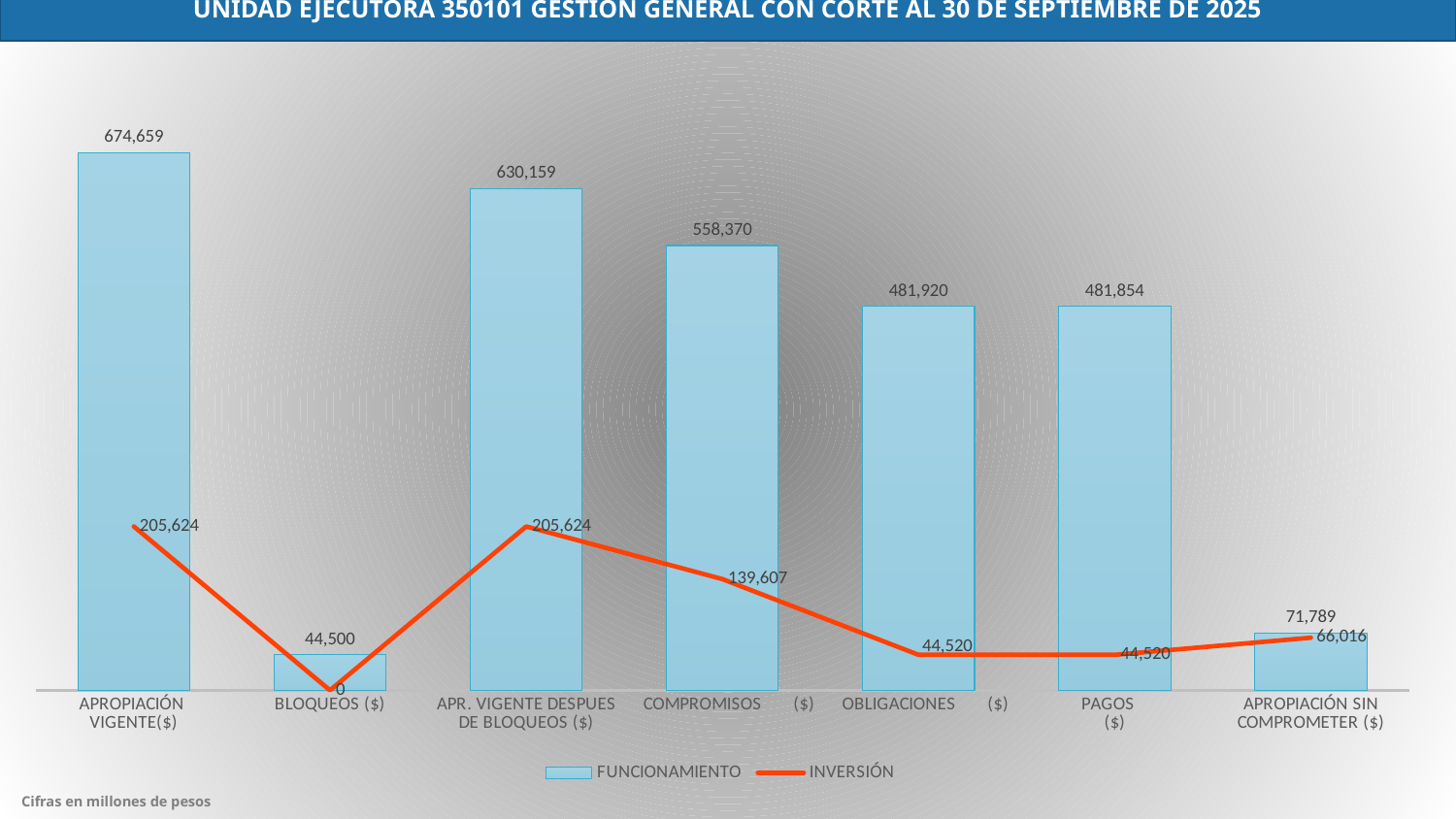
What kind of chart is shown on the slide? Bar chart with a line series What is the FUNCIONAMIENTO value for APROPIACIÓN VIGENTE($)? 674,659 Which category has the lowest FUNCIONAMIENTO value? BLOQUEOS ($) What is the INVERSIÓN value for COMPROMISOS ($)? 139,607 What is the difference between the FUNCIONAMIENTO values for APROPIACIÓN VIGENTE($) and APR. VIGENTE DESPUES DE BLOQUEOS ($)? 44,500 What is the difference between the INVERSIÓN values for APR. VIGENTE DESPUES DE BLOQUEOS ($) and COMPROMISOS ($)? 66,017 What is the FUNCIONAMIENTO value for APROPIACIÓN SIN COMPROMETER ($)? 71,789 How many series does the legend list? 2 How many categories are shown on the x axis? 7 Which category has the highest FUNCIONAMIENTO value? APROPIACIÓN VIGENTE($) Which is larger, the FUNCIONAMIENTO value for COMPROMISOS ($) or for OBLIGACIONES ($)? COMPROMISOS ($) What is the INVERSIÓN value for BLOQUEOS ($)? 0